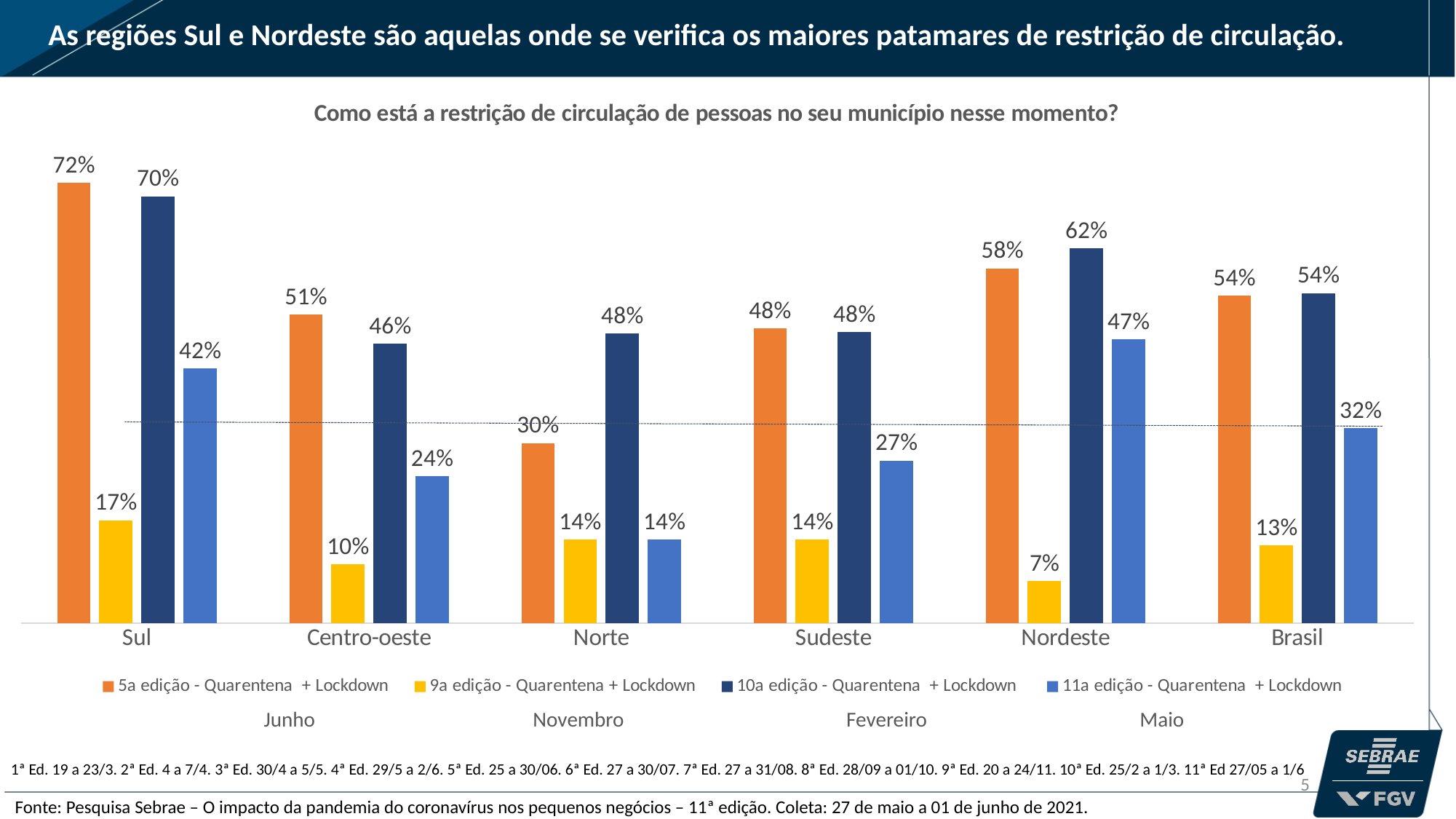
Which month is shown under the 9a edição series in the legend? Novembro What is the value for Nordeste in the 11a edição - Quarentena + Lockdown series? 47% What is the difference between the 5a edição and 11a edição values for Sul? 30% Which category has the lowest value in the 9a edição - Quarentena + Lockdown series? Nordeste Which region has the highest value in the 10a edição - Quarentena + Lockdown series? Sul What is the value for Sul in the 5a edição - Quarentena + Lockdown series? 72% What is the value for Brasil in the 11a edição - Quarentena + Lockdown series? 32% What kind of chart is shown on the slide? Bar chart Which is larger for Norte: the 5a edição value or the 10a edição value? 10a edição What is the value for Centro-oeste in the 9a edição - Quarentena + Lockdown series? 10% How many categories are shown on the x axis? 6 How many series does the legend list? 4